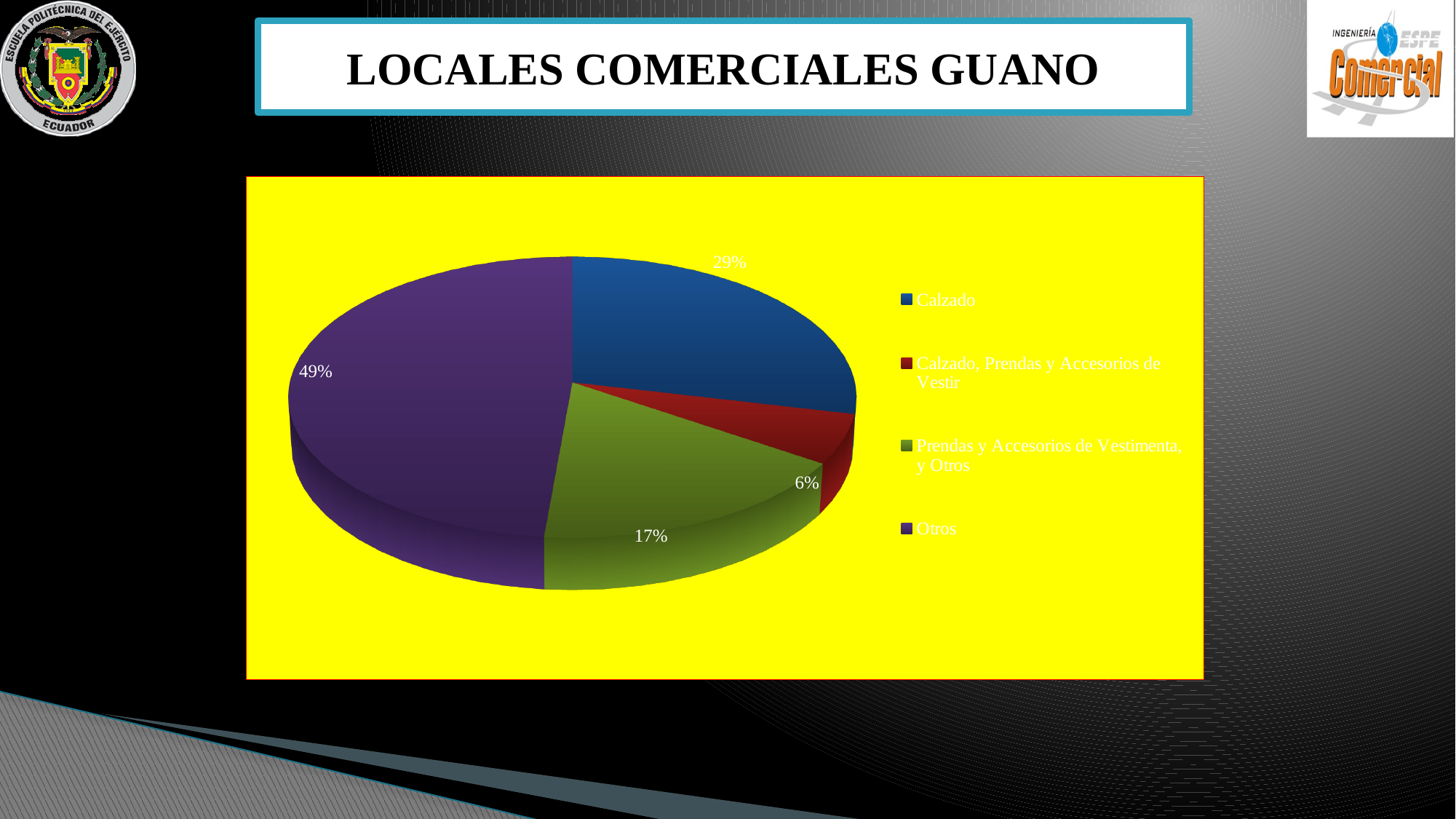
Which category has the smallest slice of the pie? Calzado, Prendas y Accesorios de Vestir What share of the pie does Calzado represent? 29% What kind of chart is shown on the slide? Pie chart How many categories does the pie chart show? 4 What is the title of the slide containing the chart? LOCALES COMERCIALES GUANO Which category has the largest slice of the pie? Otros What share of the pie does Otros represent? 49% Which is larger, the slice for Calzado or the slice for Prendas y Accesorios de Vestimenta, y Otros? Calzado What share of the pie does Prendas y Accesorios de Vestimenta, y Otros represent? 17% What colour is the slice for Otros? Purple What share of the pie does Calzado, Prendas y Accesorios de Vestir represent? 6% What is the difference in percentage points between Otros and Calzado? 20 percentage points